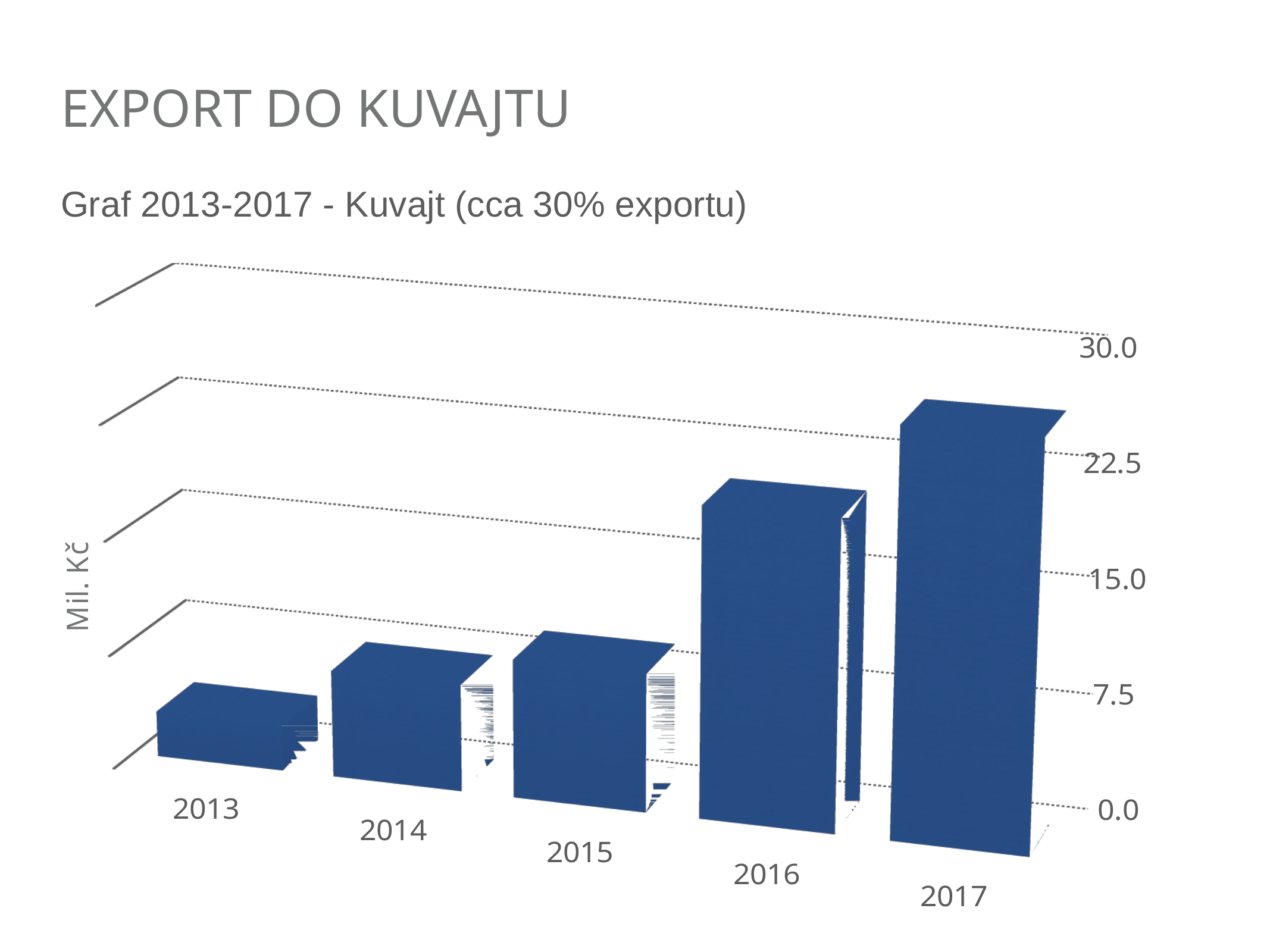
Is the value for 2016 greater or less than 15.0? greater Is the value for 2014 greater or less than 15.0? less What kind of chart is shown on the slide? bar chart Do the export values rise or fall from 2013 to 2017? rise Which year has the lowest export value in the chart? 2013 Is the value for 2013 greater or less than 7.5? less Which year has the highest export value in the chart? 2017 Which year has the larger export value, 2014 or 2016? 2016 What is the title of the chart? Graf 2013-2017 - Kuvajt (cca 30% exportu) How many years are shown on the x axis of the chart? 5 What is the label on the vertical axis of the chart? Mil. Kč